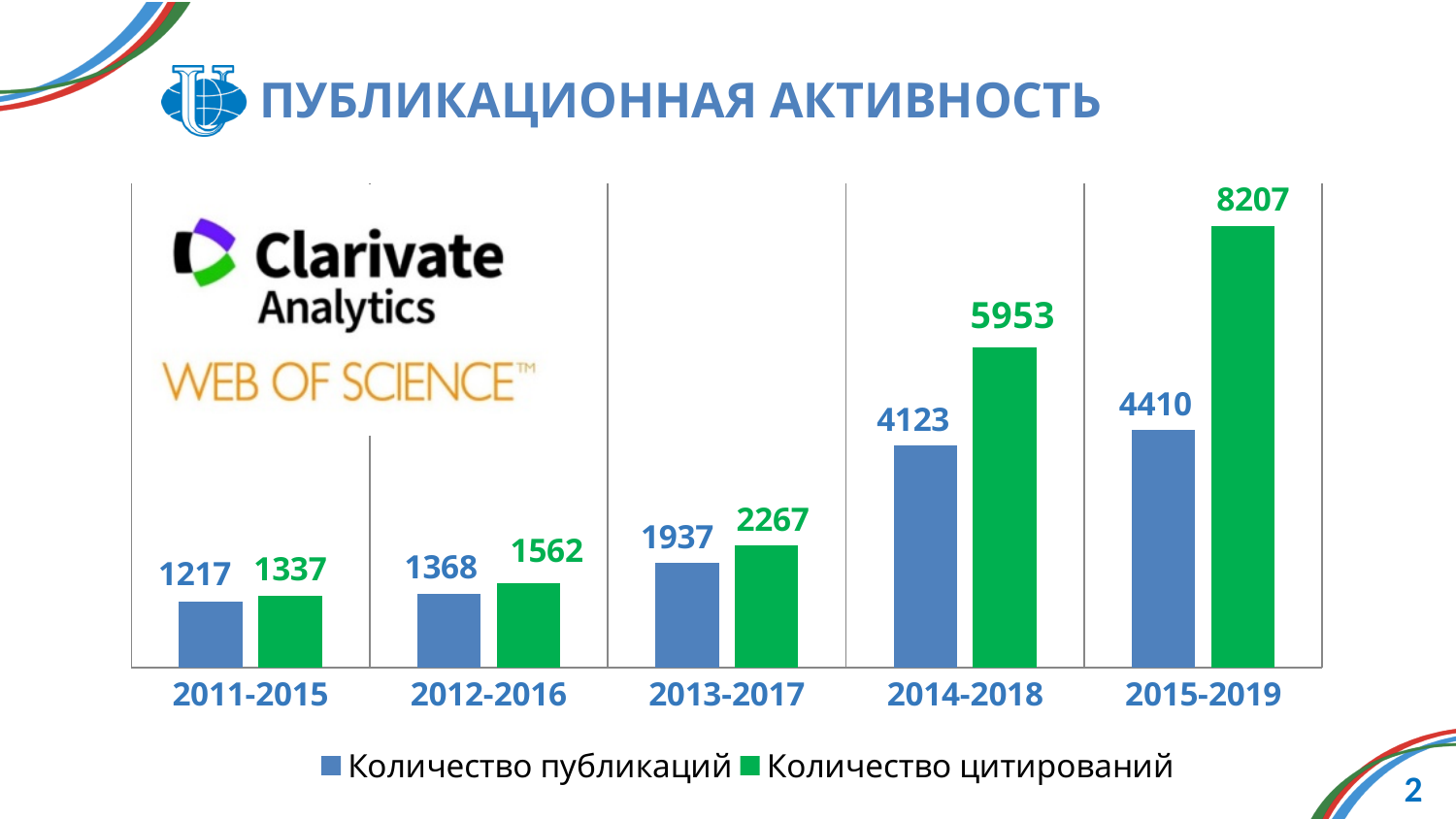
Do the number of citations rise or fall from 2011-2015 to 2015-2019? Rise How many periods are shown on the x axis? 5 What is the difference between the number of citations and the number of publications in 2014-2018? 1830 Which is larger: the number of publications in 2012-2016 or the number of citations in 2012-2016? Количество цитирований (1562) What kind of chart is shown on the slide? Bar chart What is the number of citations (Количество цитирований) for 2011-2015? 1337 How many series does the legend list? 2 What is the number of publications (Количество публикаций) for 2013-2017? 1937 What is the number of citations (Количество цитирований) for 2015-2019? 8207 Which period has the lowest number of citations (Количество цитирований)? 2011-2015 What colour represents Количество цитирований in the legend? Green Which period has the highest number of publications (Количество публикаций)? 2015-2019